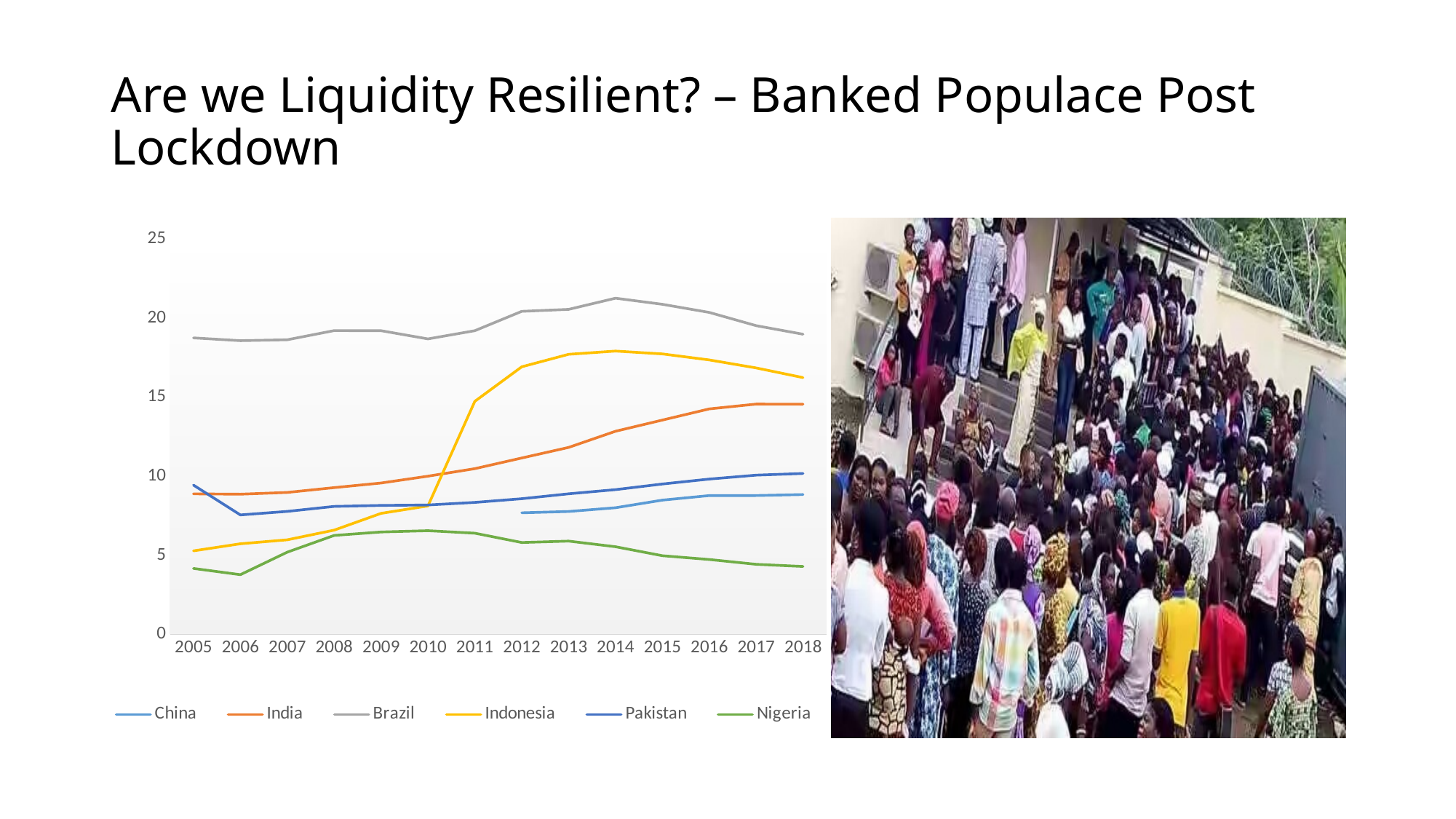
Which country has the highest value in 2018? Brazil Which series in the legend only begins in 2012 rather than 2005? China What kind of chart is shown on the slide? line chart Which country has the lowest value in 2018? Nigeria How many years are shown along the x axis? 14 Does the Nigeria line rise or fall from 2010 to 2018? fall Does the India line rise or fall from 2005 to 2018? rise Is the value for Brazil in 2014 greater or less than 20? greater How many series does the legend list? 6 In 2018, which is larger: the value for Indonesia or the value for India? Indonesia Is the value for Indonesia in 2014 greater or less than 15? greater Is the value for Nigeria in 2018 greater or less than 5? less